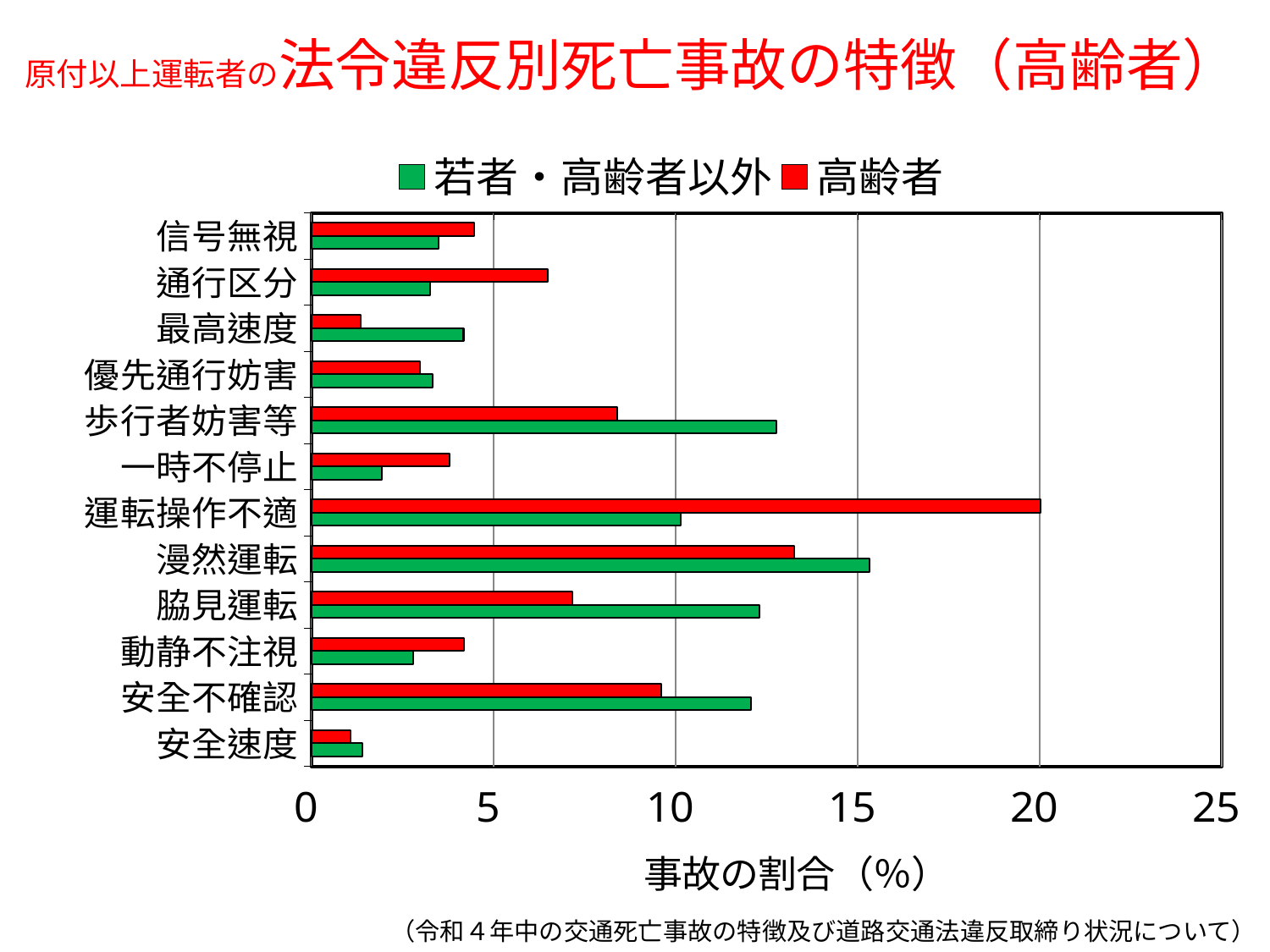
Which category has the highest value for 若者・高齢者以外? 漫然運転 For 脇見運転, which series has the larger value, 若者・高齢者以外 or 高齢者? 若者・高齢者以外 How many violation categories are plotted on the chart? 12 What is the label of the horizontal axis? 事故の割合（%） Is the 高齢者 value for 運転操作不適 greater or less than 15? greater For 通行区分, which series has the larger value, 若者・高齢者以外 or 高齢者? 高齢者 Is the 若者・高齢者以外 value for 歩行者妨害等 greater or less than 10? greater Is the 高齢者 value for 最高速度 greater or less than 5? less Which category has the highest value for 高齢者? 運転操作不適 What kind of chart is shown on the slide? bar chart How many series does the legend list? 2